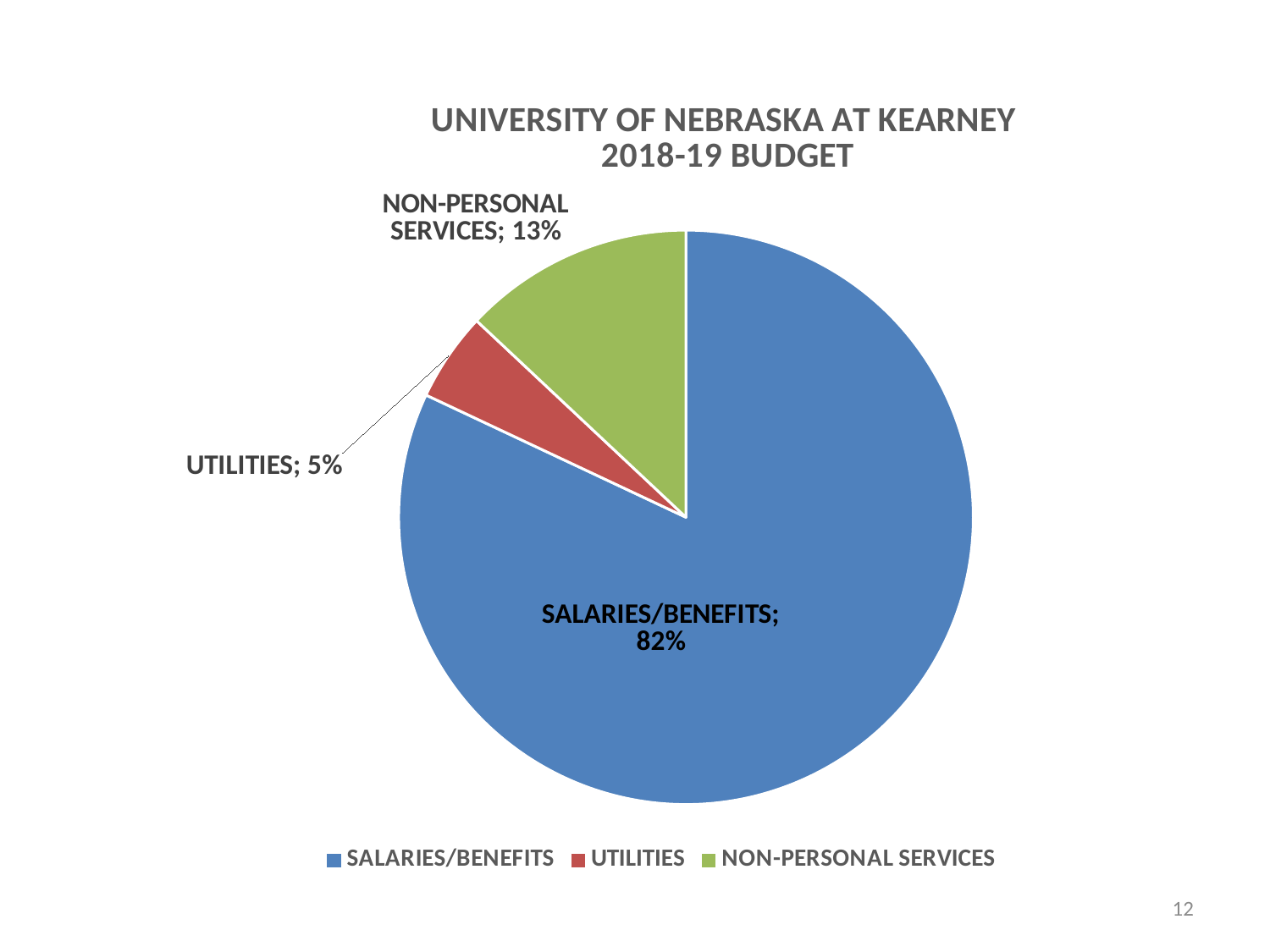
Which category has the smallest share of the budget? UTILITIES What is the title of the chart? UNIVERSITY OF NEBRASKA AT KEARNEY 2018-19 BUDGET Which is larger, the share for NON-PERSONAL SERVICES or the share for UTILITIES? NON-PERSONAL SERVICES What share of the budget is UTILITIES? 5% What colour is the UTILITIES slice? red What share of the budget is SALARIES/BENEFITS? 82% What kind of chart is shown on the slide? pie chart What share of the budget is NON-PERSONAL SERVICES? 13% What is the difference in percentage points between NON-PERSONAL SERVICES and UTILITIES? 8 percentage points How many entries does the legend list? 3 How many categories does the pie chart show? 3 Which category has the largest share of the budget? SALARIES/BENEFITS